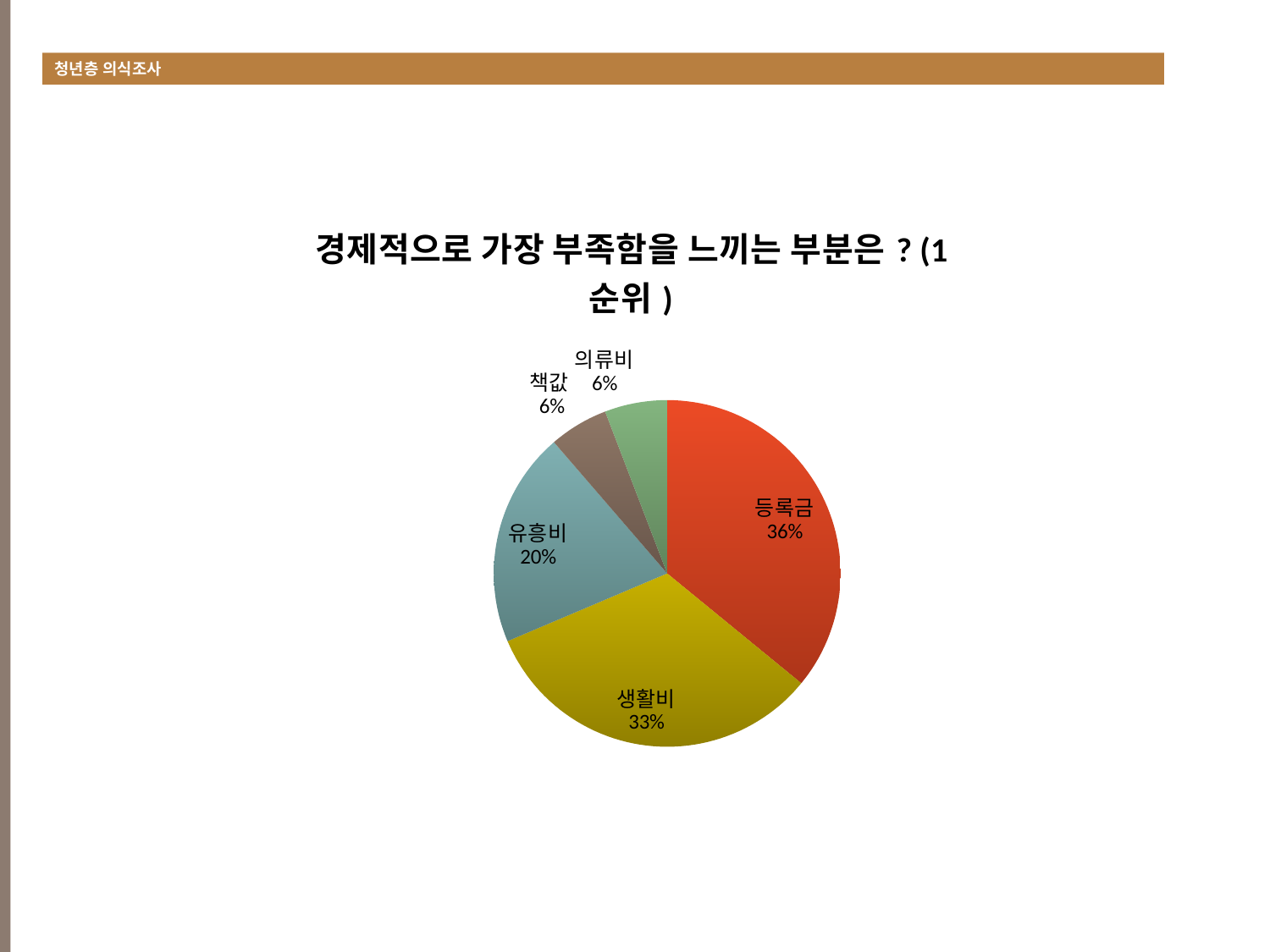
What is the title of the chart? 경제적으로 가장 부족함을 느끼는 부분은 ? (1 순위 ) What share of the pie does 의류비 have? 6% What kind of chart is shown on the slide? pie chart Which is larger, the share of 유흥비 or the share of 책값? 유흥비 What share of the pie does 책값 have? 6% Which category has the largest share of the pie? 등록금 How many slices does the pie chart have? 5 What is the difference between the shares of 등록금 and 생활비? 3% What share of the pie does 유흥비 have? 20% What is the difference between the shares of 생활비 and 유흥비? 13%